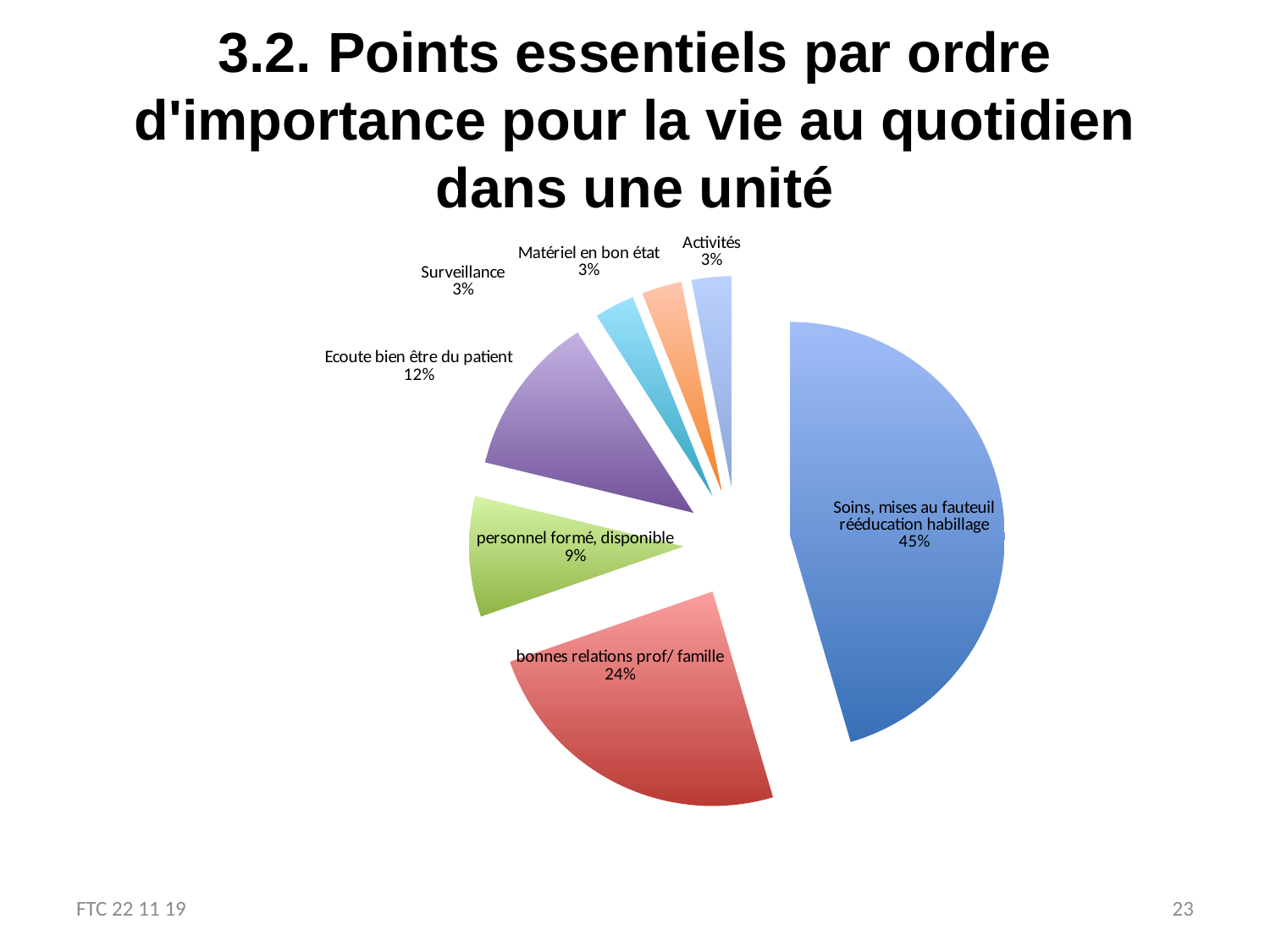
What percentage is shown for "bonnes relations prof/ famille"? 24% What is the combined share of "Surveillance", "Matériel en bon état" and "Activités"? 9% How many slices does the pie chart have? 7 What percentage is shown for "Ecoute bien être du patient"? 12% What kind of chart is shown on the slide? pie chart Which is larger, "Ecoute bien être du patient" or "personnel formé, disponible"? Ecoute bien être du patient What colour is the slice for "bonnes relations prof/ famille"? red What is the difference in percentage points between "Soins, mises au fauteuil rééducation habillage" and "bonnes relations prof/ famille"? 21 What percentage is shown for "personnel formé, disponible"? 9% What percentage is shown for "Surveillance"? 3% Which category has the largest slice of the pie? Soins, mises au fauteuil rééducation habillage What share of the pie does "Soins, mises au fauteuil rééducation habillage" represent? 45%